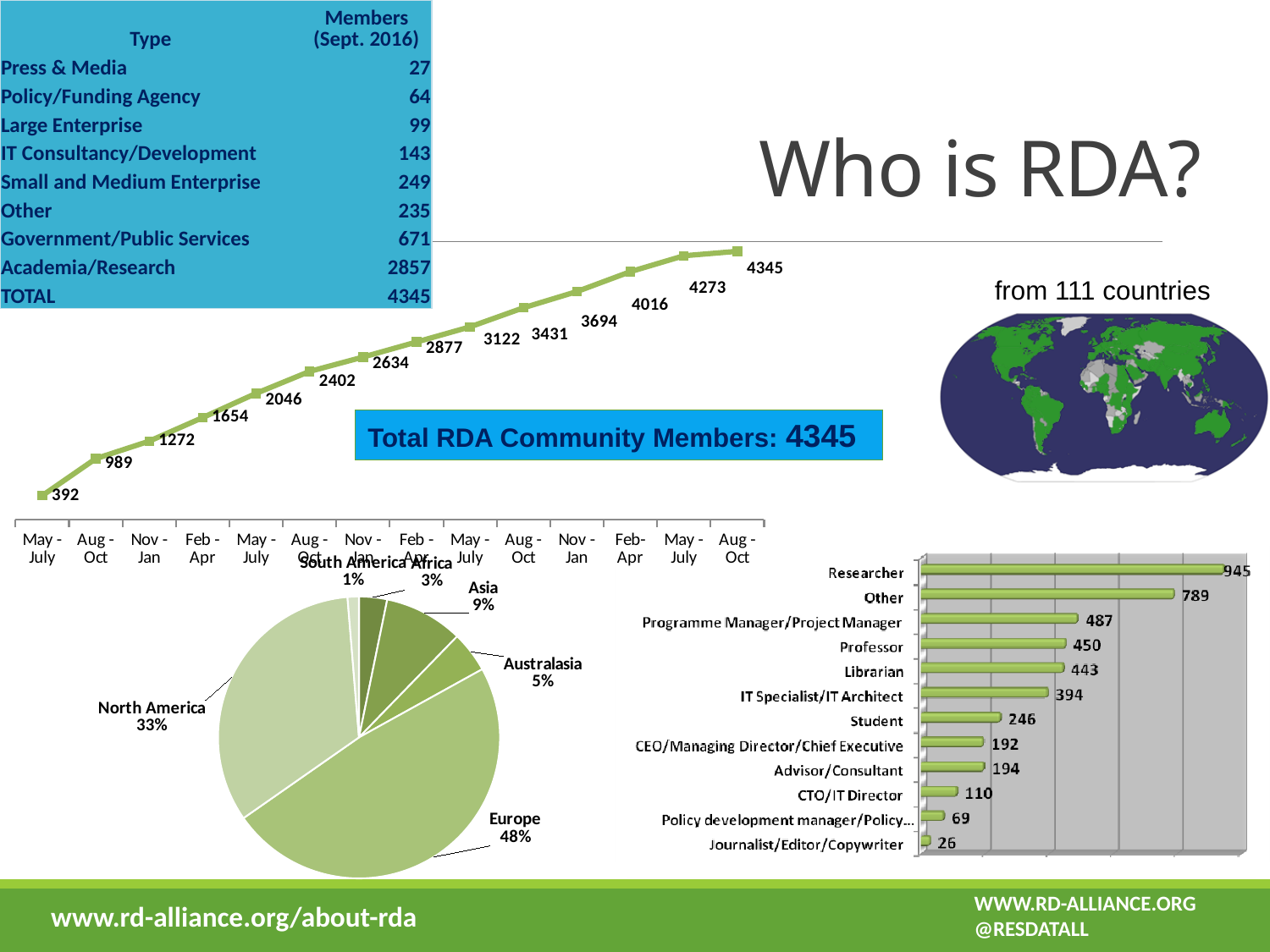
In the horizontal bar chart at the bottom right, how many categories are shown? 12 In the line chart in the middle of the slide, what is the value of the last data point? 4345 In the pie chart at the bottom left, what is the difference between the shares of Europe and North America? 15% In the horizontal bar chart at the bottom right, what is the value for Researcher? 945 In the horizontal bar chart at the bottom right, which is larger, the value for Student or the value for CTO/IT Director? Student In the pie chart at the bottom left, which region has the smallest slice? South America In the line chart in the middle of the slide, do the values rise or fall along the x axis? rise In the horizontal bar chart at the bottom right, which category has the lowest value? Journalist/Editor/Copywriter What kind of chart is the chart at the bottom right of the slide? bar chart In the horizontal bar chart at the bottom right, what is the difference between the values for Researcher and Other? 156 In the pie chart at the bottom left, what share does Europe have? 48% In the pie chart at the bottom left, how many slices are there? 6